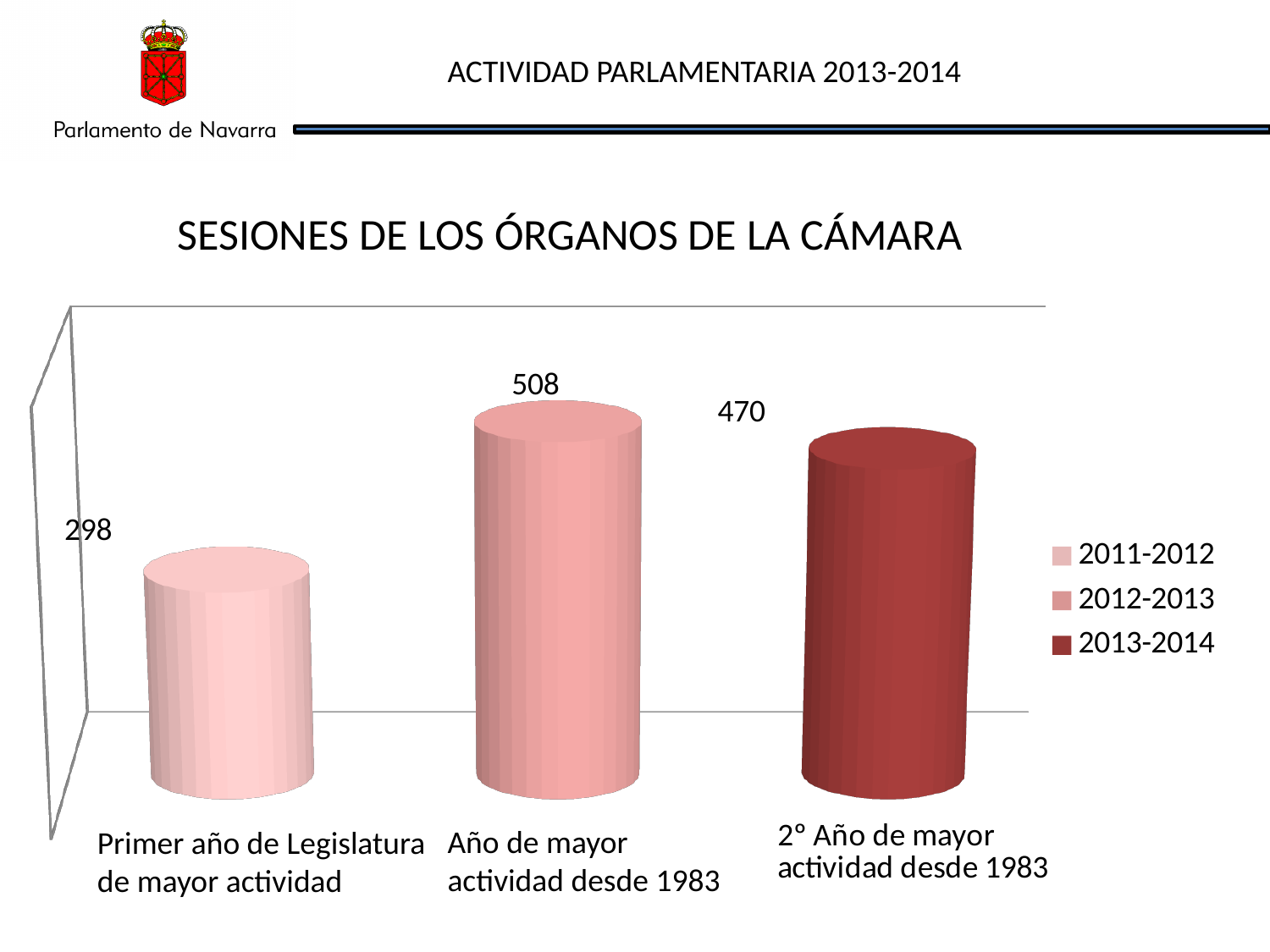
What is the title of the chart? SESIONES DE LOS ÓRGANOS DE LA CÁMARA What is the difference between the values for 2012-2013 and 2011-2012? 210 Which series has the lowest value? 2011-2012 What is the difference between the values for 2012-2013 and 2013-2014? 38 What kind of chart is shown on the slide? Bar chart What is the value for 2013-2014 in the chart? 470 What is the value for 2011-2012 in the chart? 298 Which is larger, the value for 2011-2012 or the value for 2013-2014? 2013-2014 What is the value for 2012-2013 in the chart? 508 Which series has the highest value? 2012-2013 How many series does the legend list? 3 How many bars are plotted in the chart? 3